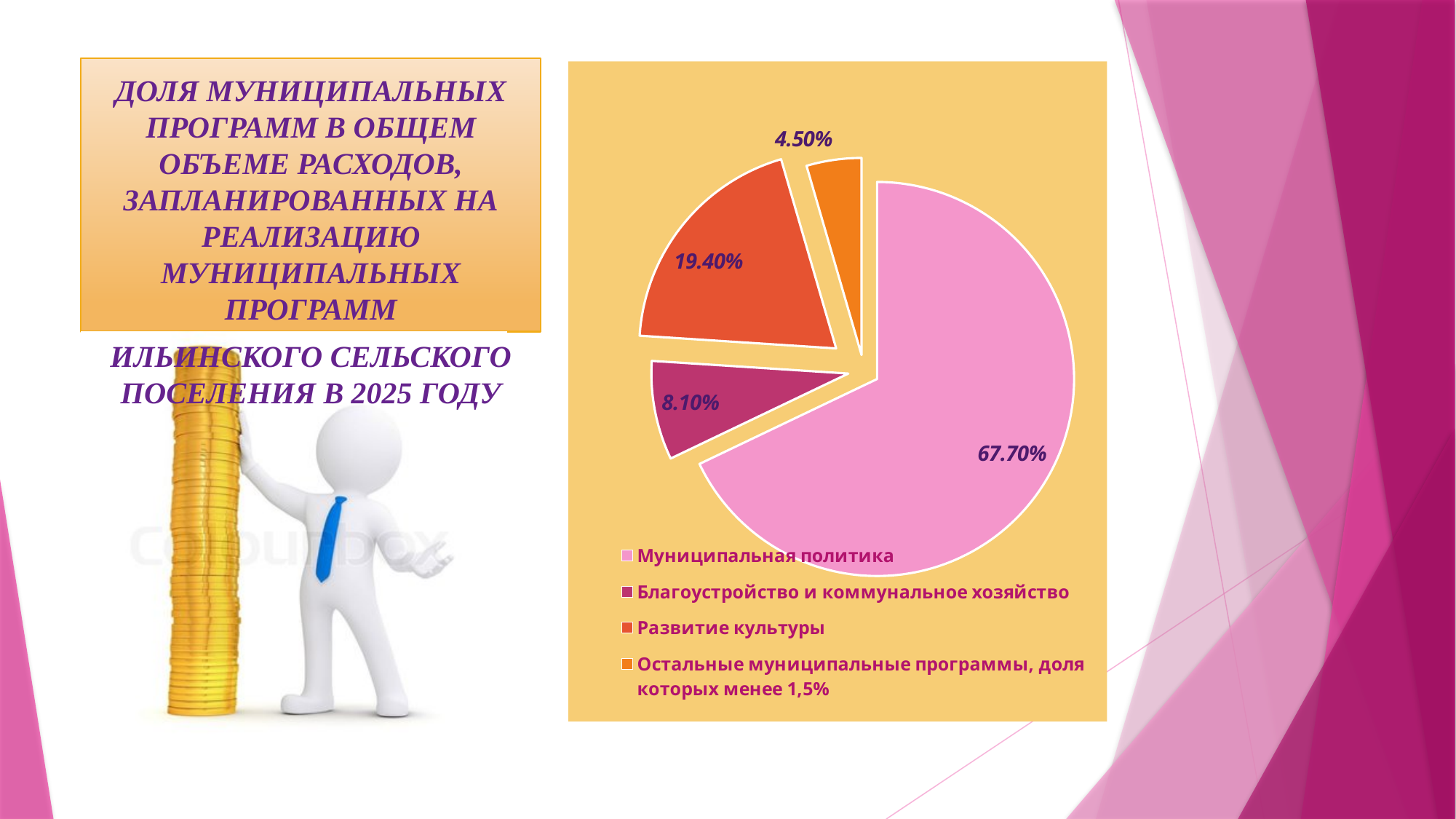
What type of chart is shown on the slide? Pie chart What share of the pie does "Муниципальная политика" have? 67.70% What is the difference between the shares of "Развитие культуры" and "Благоустройство и коммунальное хозяйство"? 11.30% Which category has the smallest slice of the pie? Остальные муниципальные программы, доля которых менее 1,5% What colour is the slice for "Муниципальная политика"? Pink What is the value shown for "Благоустройство и коммунальное хозяйство"? 8.10% How many entries does the legend list? 4 How many slices does the pie chart have? 4 What is the value shown for "Развитие культуры"? 19.40% What is the value shown for "Остальные муниципальные программы, доля которых менее 1,5%"? 4.50% Which category has the largest slice of the pie? Муниципальная политика Which is larger: the share of "Развитие культуры" or the share of "Благоустройство и коммунальное хозяйство"? Развитие культуры